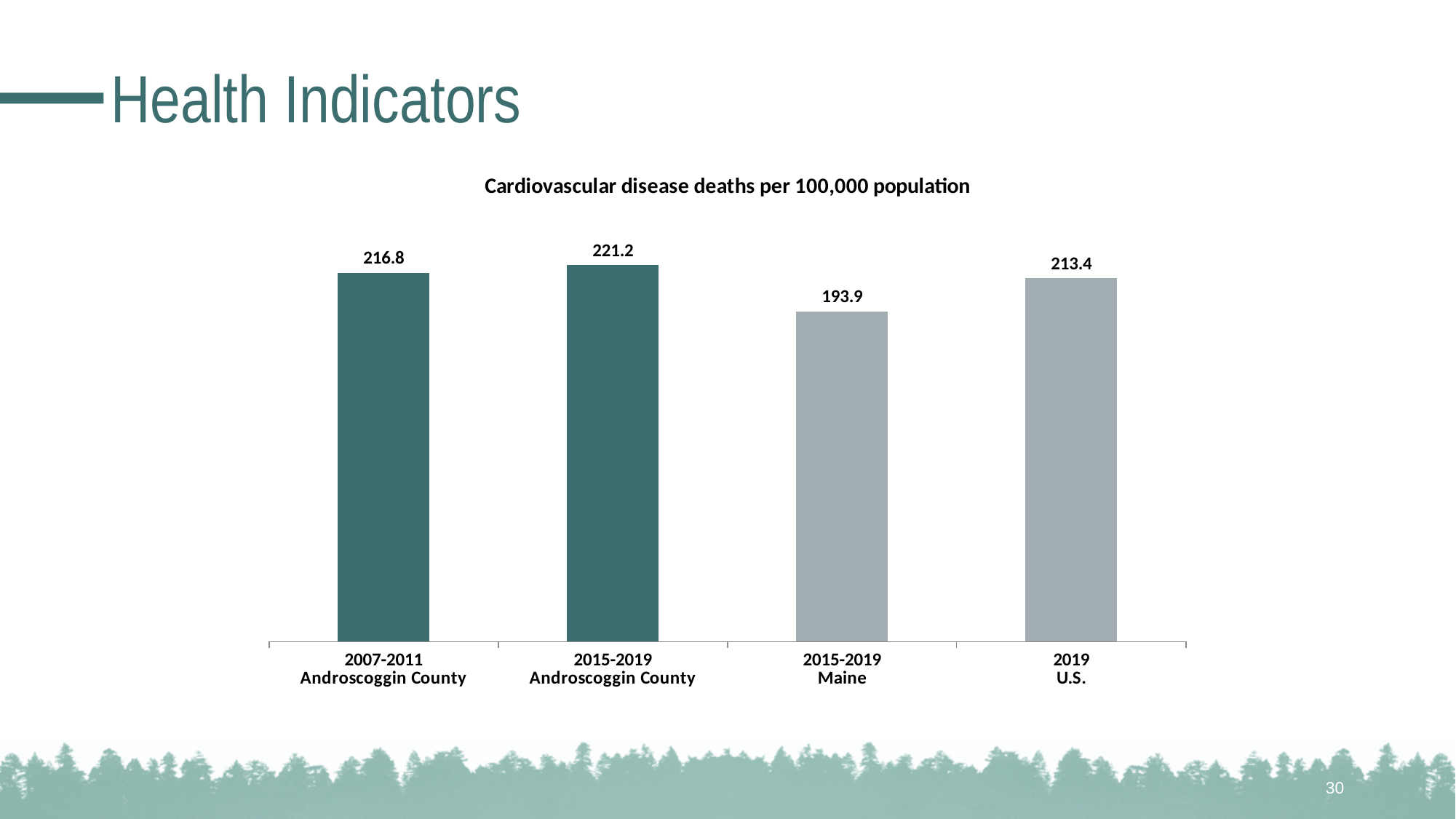
What is the value for 2015-2019 Maine? 193.9 How many bars are shown in the chart? 4 Which bars are coloured dark teal rather than grey? The two Androscoggin County bars What is the difference between the 2015-2019 Androscoggin County value and the 2015-2019 Maine value? 27.3 What is the value for 2007-2011 Androscoggin County? 216.8 What is the difference between the 2015-2019 Androscoggin County value and the 2007-2011 Androscoggin County value? 4.4 Which category has the lowest value? 2015-2019 Maine What kind of chart is shown on the slide? Bar chart What is the title of the chart? Cardiovascular disease deaths per 100,000 population Which is larger, the value for 2019 U.S. or the value for 2015-2019 Maine? 2019 U.S. What is the value for 2019 U.S.? 213.4 Which category has the highest value? 2015-2019 Androscoggin County